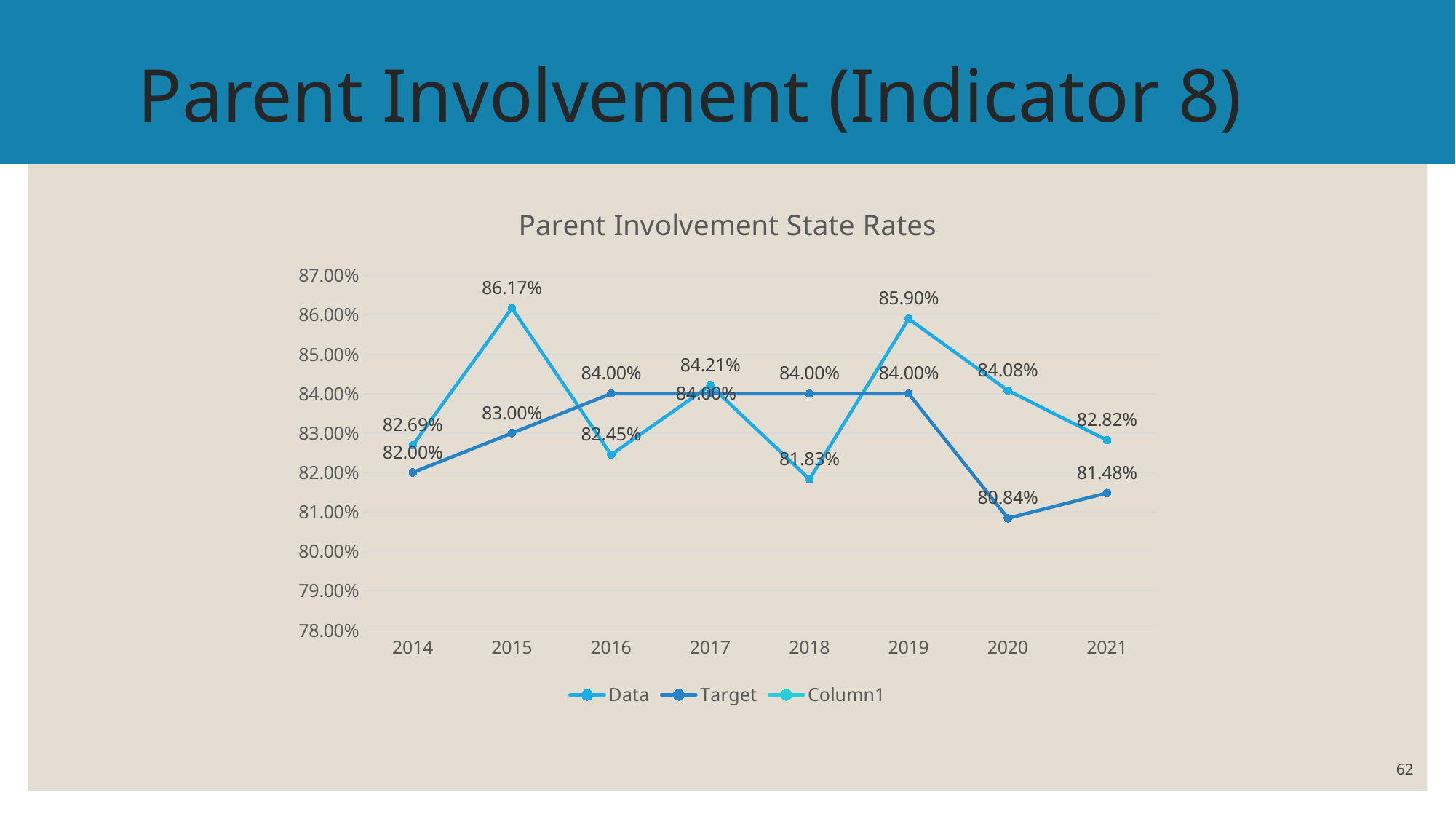
What is the difference between the Data value and the Target value in 2019? 1.90% Does the Data series rise or fall from 2019 to 2021? fall What type of chart is shown on the slide? line chart How many years are shown on the x axis? 8 What is the title of the chart? Parent Involvement State Rates Which is larger in 2016, the Data value or the Target value? Target What is the Data value for 2015? 86.17% In which year is the Target series lowest? 2020 In which year is the Data series highest? 2015 What is the Target value for 2020? 80.84% What is the Data value for 2018? 81.83% How many series does the legend list? 3